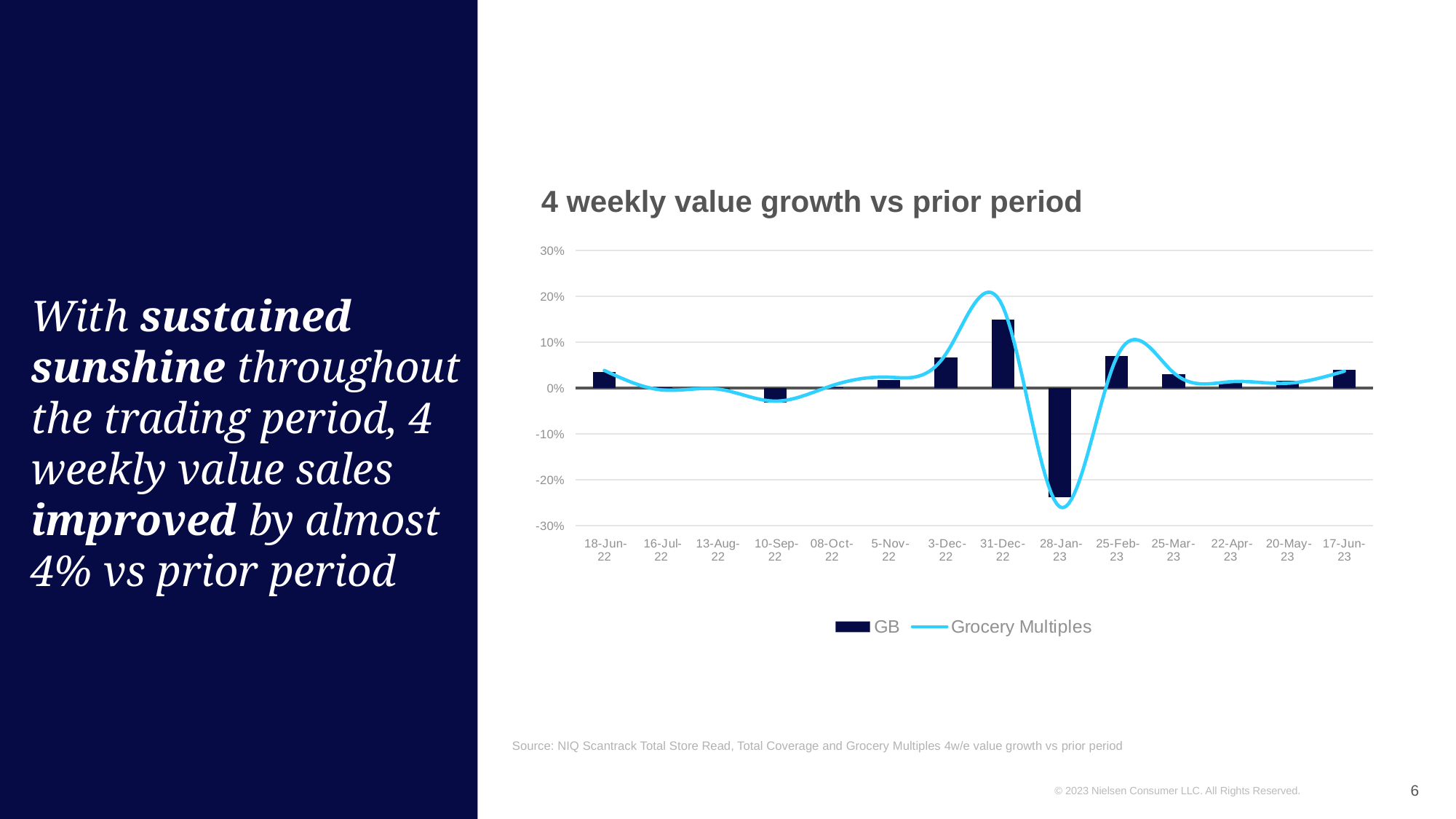
How many dates are shown on the x axis of the chart? 14 Is the GB value for 28-Jan-23 greater or less than -20%? less On which date does the Grocery Multiples line reach its lowest point? 28-Jan-23 What is the title of the chart? 4 weekly value growth vs prior period How many series does the chart's legend list? 2 On which date is the GB bar lowest? 28-Jan-23 Which is larger for GB: the value for 25-Feb-23 or the value for 25-Mar-23? 25-Feb-23 On which date is the GB bar highest? 31-Dec-22 Is the GB value for 31-Dec-22 greater or less than 10%? greater Which series is shown as a line in the chart? Grocery Multiples Is the Grocery Multiples value for 28-Jan-23 greater or less than -20%? less On which date does the Grocery Multiples line reach its highest point? 31-Dec-22